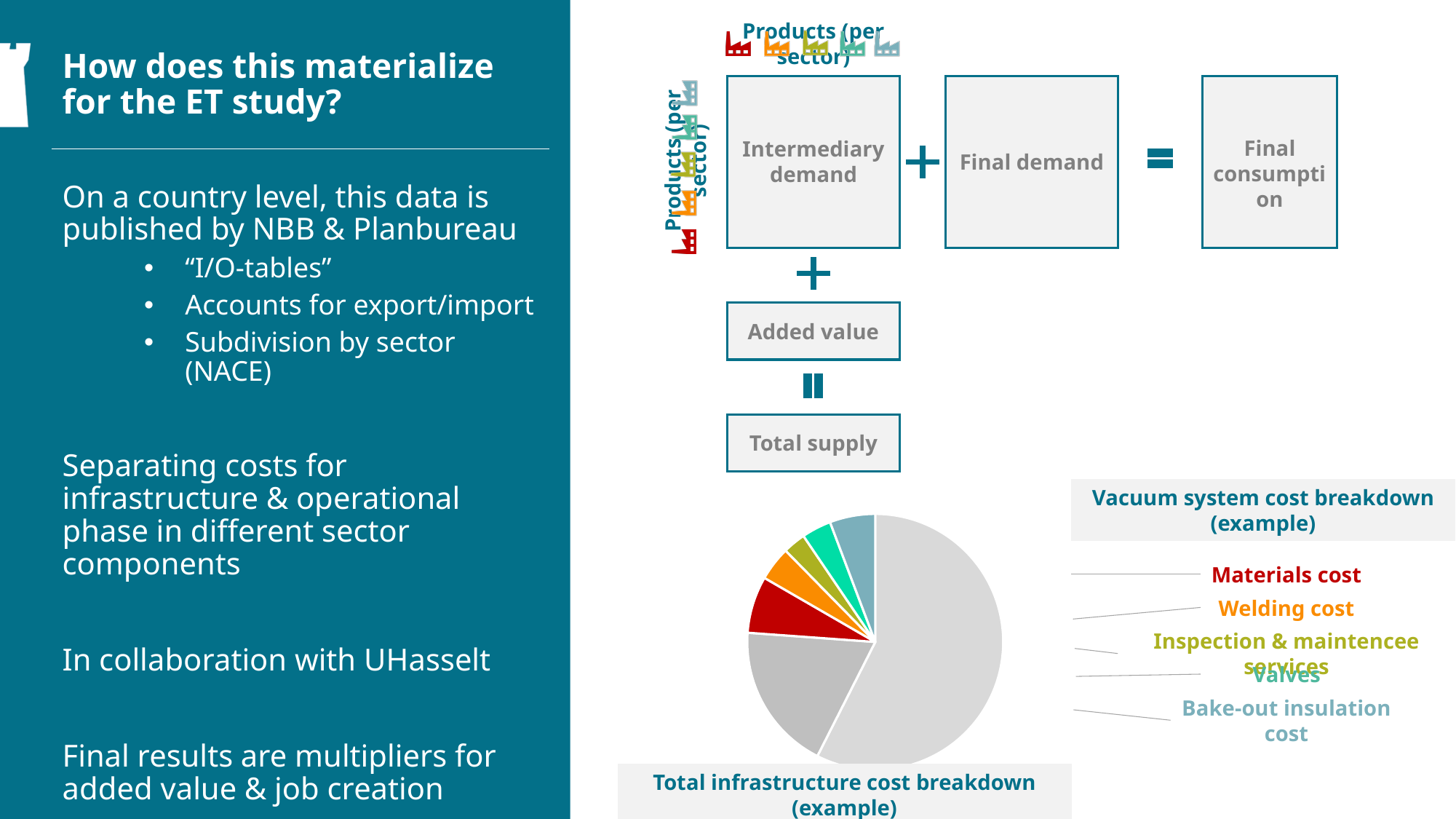
In the pie chart, which is larger: the Materials cost slice or the Bake-out insulation cost slice? Materials cost How many slices does the pie chart have in total? 7 What is the title of the pie chart at the bottom of the slide? Total infrastructure cost breakdown (example) How many labelled cost categories are listed next to the pie chart? 5 What colour is the Materials cost slice in the pie chart? red In the pie chart, which is larger: the Materials cost slice or the Welding cost slice? Materials cost In the pie chart, which is larger: the Materials cost slice or the Valves slice? Materials cost Among the labelled cost categories in the pie chart, which has the largest slice? Materials cost What kind of chart is shown at the bottom of the slide? pie chart